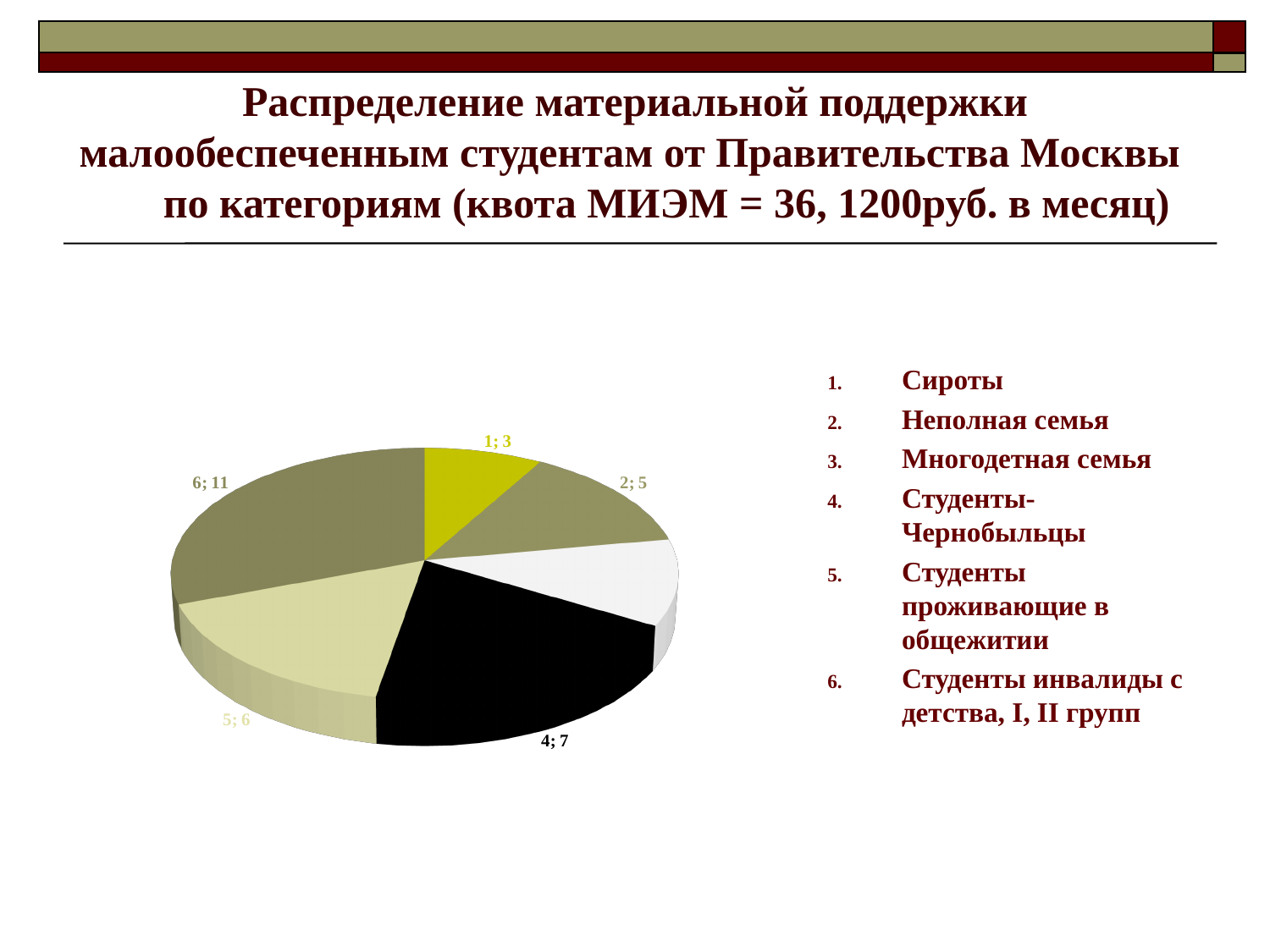
What type of chart is shown on the slide? pie chart Which category has the largest slice in the pie chart? 6 (Студенты инвалиды с детства, I, II групп) What is the difference between the values for category 4 and category 2? 2 What value is shown for category 2 (Неполная семья) in the pie chart? 5 What value is shown for category 4 (Студенты-Чернобыльцы) in the pie chart? 7 What value is shown for category 5 (Студенты проживающие в общежитии) in the pie chart? 6 What value is shown for category 1 (Сироты) in the pie chart? 3 Which category is listed as number 3 in the legend next to the pie chart? Многодетная семья Which is larger, the value for category 4 or the value for category 5? category 4 What value is shown for category 6 (Студенты инвалиды с детства, I, II групп) in the pie chart? 11 How many slices does the pie chart have? 6 What is the difference between the values for category 6 and category 1? 8